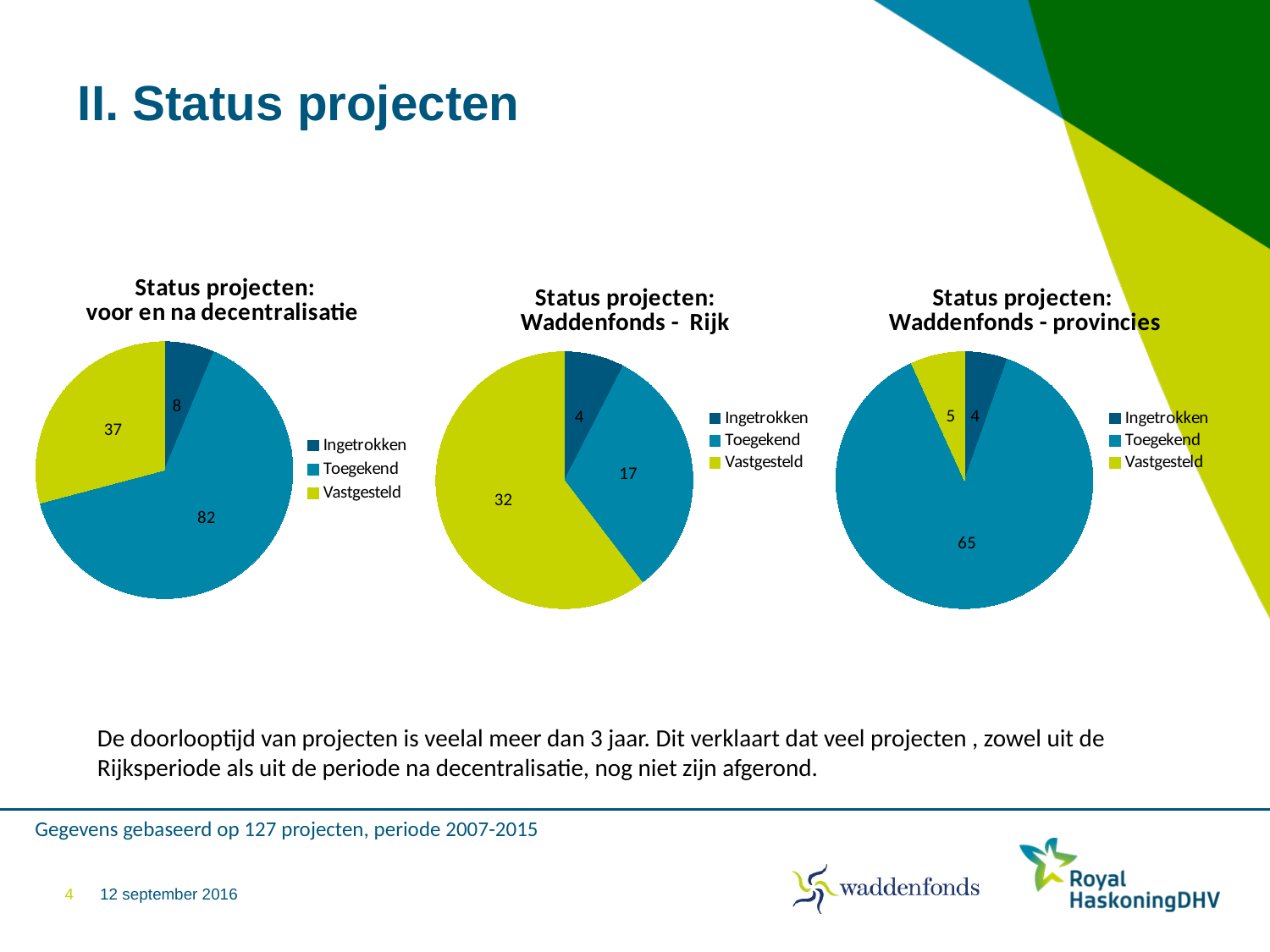
In the 'Status projecten: voor en na decentralisatie' chart, what is the difference between Toegekend and Vastgesteld? 45 In the 'Status projecten: Waddenfonds - provincies' chart, what is the value for Toegekend? 65 In the 'Status projecten: Waddenfonds - Rijk' chart, which category has the smallest slice? Ingetrokken In the 'Status projecten: Waddenfonds - Rijk' chart, what is the value for Vastgesteld? 32 In the 'Status projecten: Waddenfonds - Rijk' chart, what is the difference between Vastgesteld and Toegekend? 15 How many categories does the legend of the 'Status projecten: Waddenfonds - provincies' chart list? 3 In the 'Status projecten: voor en na decentralisatie' chart, what is the value for Toegekend? 82 In the 'Status projecten: voor en na decentralisatie' chart, what is the value for Vastgesteld? 37 In the 'Status projecten: Waddenfonds - Rijk' chart, which category has the largest slice? Vastgesteld What kind of chart is 'Status projecten: Waddenfonds - Rijk'? Pie chart In the 'Status projecten: Waddenfonds - provincies' chart, which is larger, Vastgesteld or Toegekend? Toegekend In the 'Status projecten: voor en na decentralisatie' chart, which category has the largest slice? Toegekend